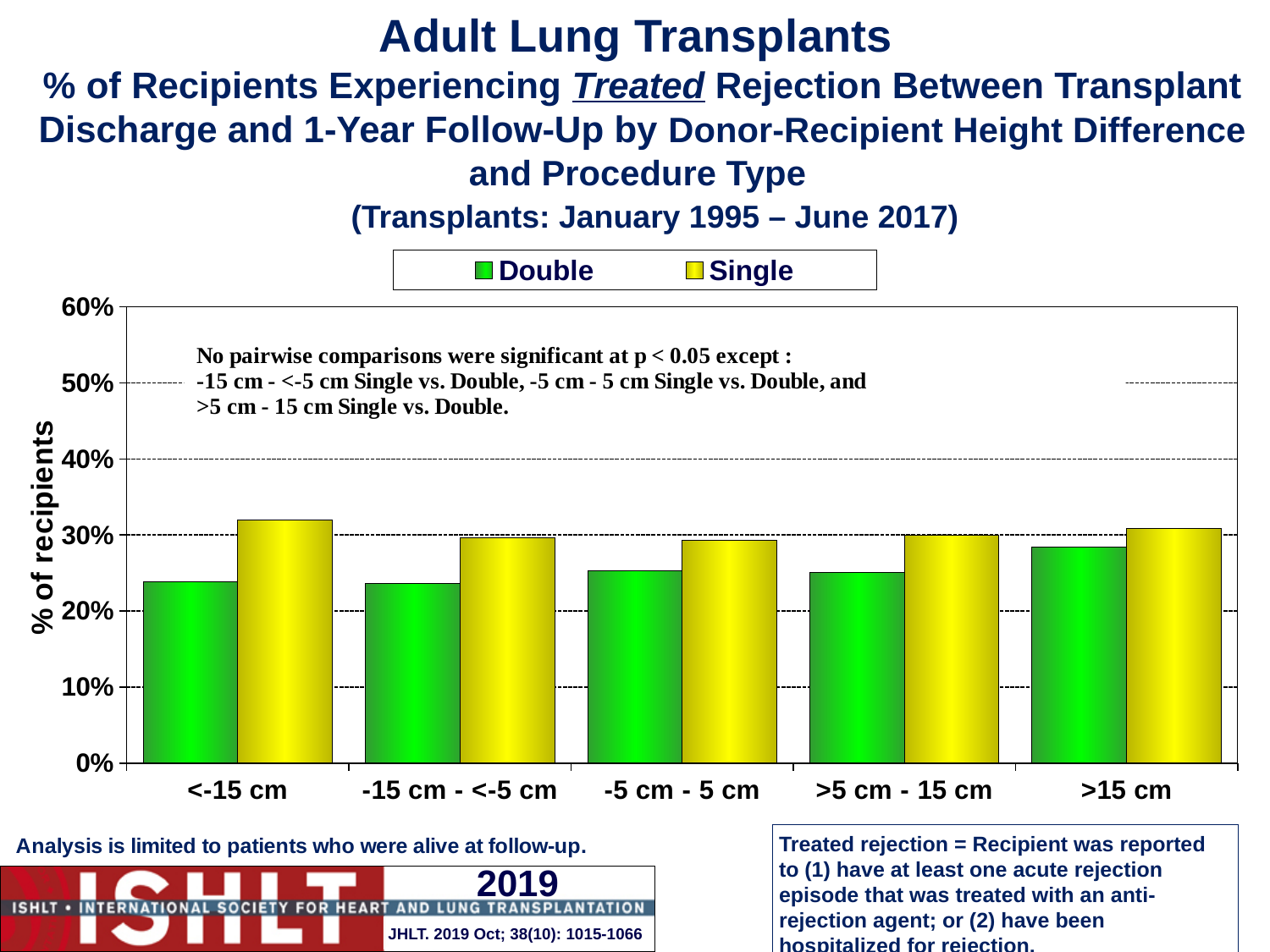
Is the value for Double in the >15 cm category greater or less than 30%? less In the <-15 cm category, which is larger, Double or Single? Single Which series is shown in green in the legend? Double How many donor-recipient height difference categories are shown on the x axis? 5 What is the label of the y axis? % of recipients Is the value for Double in the <-15 cm category greater or less than 30%? less Is the value for Single in the <-15 cm category greater or less than 30%? greater What kind of chart is shown on the slide? bar chart Which height difference category has the highest value for Double? >15 cm How many series does the legend list? 2